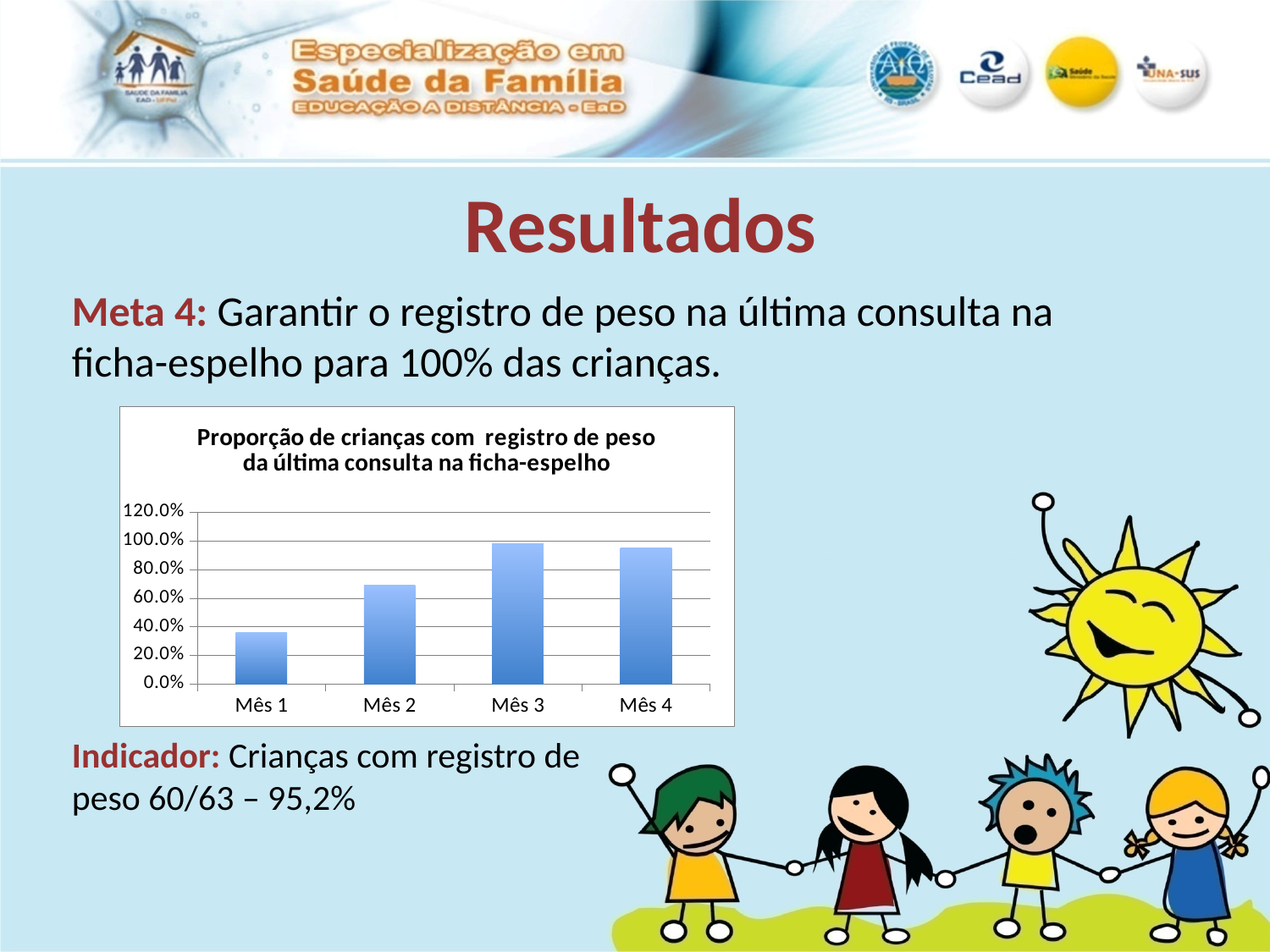
What is the title of the chart? Proporção de crianças com registro de peso da última consulta na ficha-espelho Is the value for Mês 4 greater or less than 100.0%? less Do the values rise or fall from Mês 1 to Mês 3? rise Which month has the lowest proportion of children with weight recorded? Mês 1 Is the value for Mês 1 greater or less than 40.0%? less Which is larger, the value for Mês 1 or the value for Mês 2? Mês 2 Is the value for Mês 2 greater or less than 60.0%? greater What is the highest tick value shown on the vertical axis? 120.0% What kind of chart is shown on the slide? bar chart How many categories (months) are plotted on the chart? 4